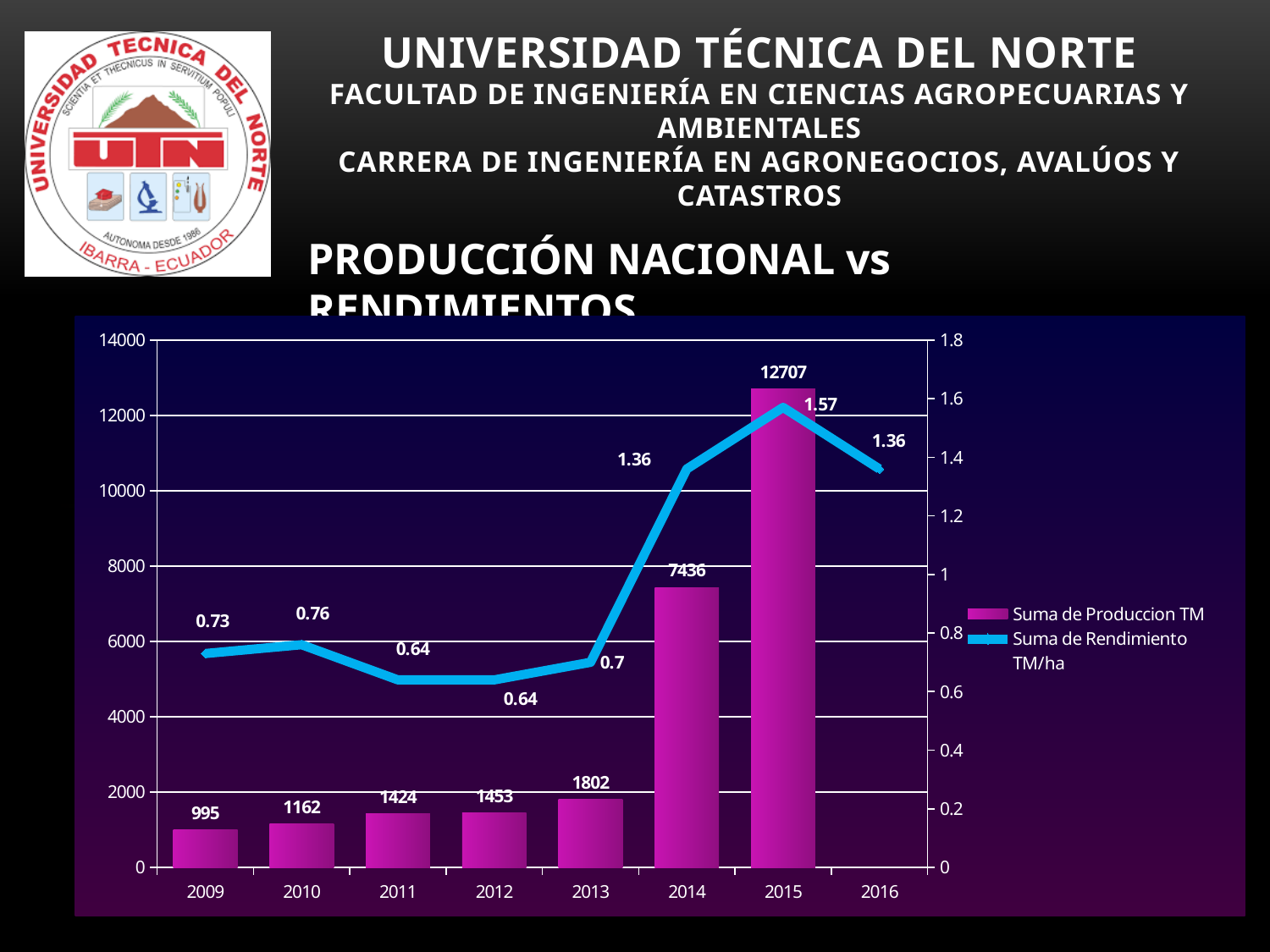
What is the value of Suma de Produccion TM for 2009? 995 What is the value of Suma de Rendimiento TM/ha for 2013? 0.7 What is the difference in Suma de Rendimiento TM/ha between 2015 and 2016? 0.21 Which year has the highest Suma de Produccion TM? 2015 How many years are shown on the x axis? 8 How many series does the legend list? 2 Which year has the highest Suma de Rendimiento TM/ha? 2015 What kind of chart is shown on the slide? Combined bar and line chart Which is larger, the Suma de Produccion TM for 2013 or for 2012? 2013 Which year has the lowest Suma de Produccion TM among the years with a bar? 2009 What is the value of Suma de Produccion TM for 2015? 12707 What is the difference in Suma de Produccion TM between 2015 and 2014? 5271